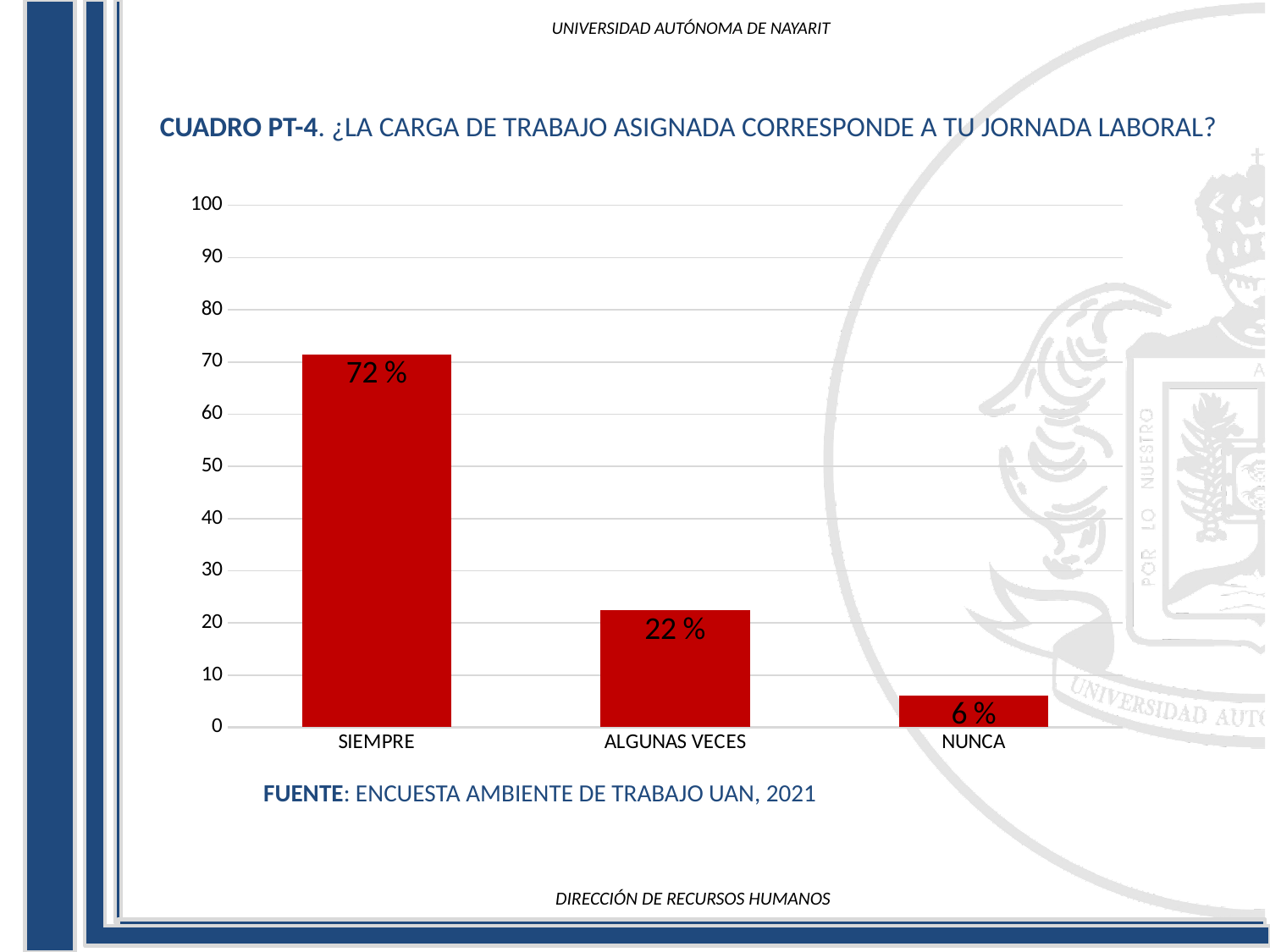
What is the value for ALGUNAS VECES? 22 % What source is cited below the chart? ENCUESTA AMBIENTE DE TRABAJO UAN, 2021 Is the value for SIEMPRE greater or less than 60? greater What kind of chart is shown on the slide? bar chart Which is larger, the value for ALGUNAS VECES or the value for NUNCA? ALGUNAS VECES What is the difference between the values for ALGUNAS VECES and NUNCA? 16 % What is the difference between the values for SIEMPRE and ALGUNAS VECES? 50 % How many categories are shown on the x axis? 3 Which category has the highest value? SIEMPRE What is the value for SIEMPRE? 72 % What is the value for NUNCA? 6 % Which category has the lowest value? NUNCA